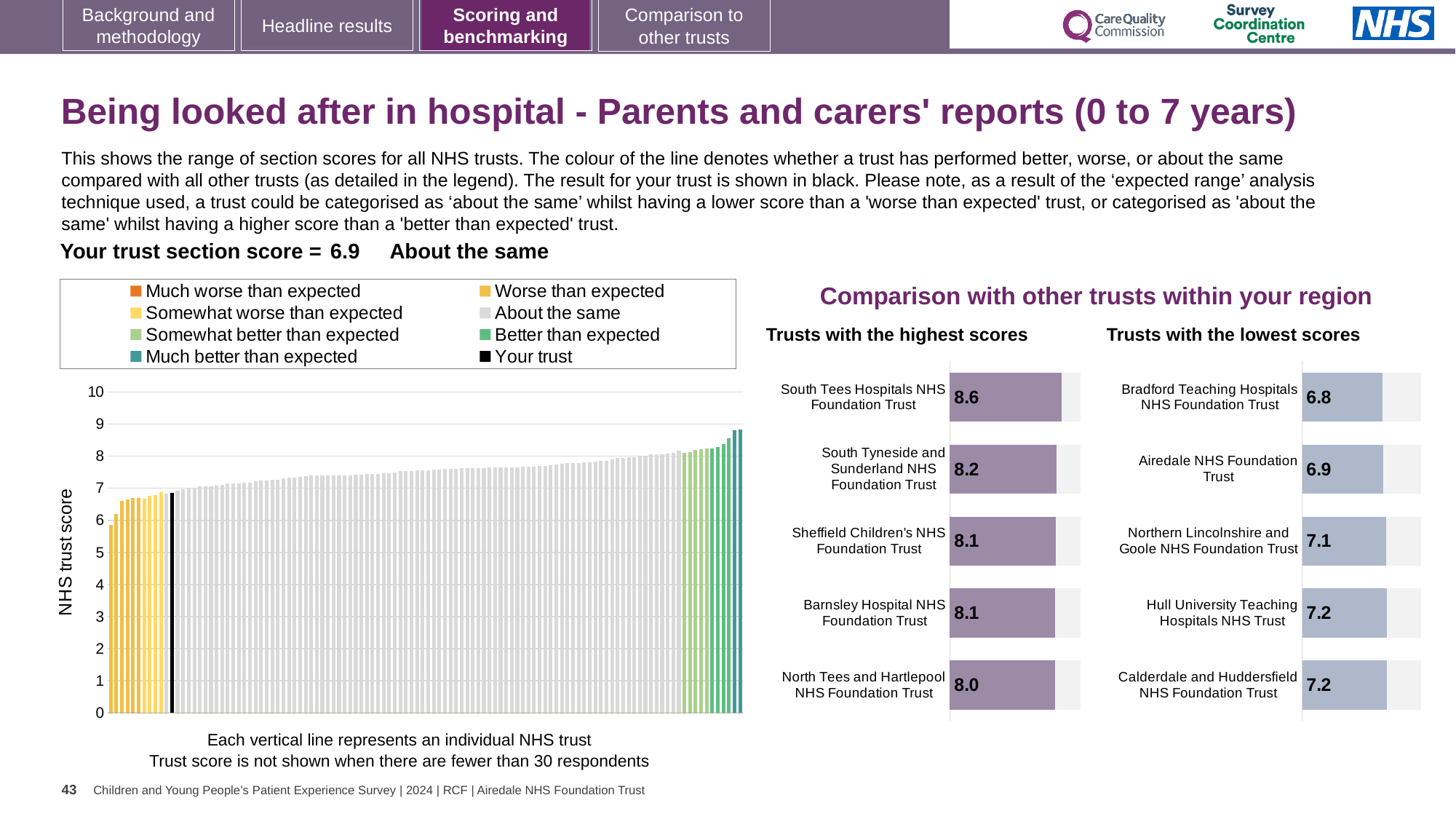
In the 'Trusts with the lowest scores' chart, which trust has the lowest score? Bradford Teaching Hospitals NHS Foundation Trust In the 'Trusts with the highest scores' chart, which trust has the lowest score shown? North Tees and Hartlepool NHS Foundation Trust What kind of chart is the large chart on the left showing NHS trust scores? Bar chart In the 'Trusts with the lowest scores' chart, what is the difference between the scores of Hull University Teaching Hospitals NHS Trust and Bradford Teaching Hospitals NHS Foundation Trust? 0.4 In the 'Trusts with the highest scores' chart, what is the difference between the scores of South Tees Hospitals NHS Foundation Trust and North Tees and Hartlepool NHS Foundation Trust? 0.6 In the 'Trusts with the lowest scores' chart, what is the score for Bradford Teaching Hospitals NHS Foundation Trust? 6.8 In the large chart on the left, do the trust scores rise or fall from left to right? Rise How many trusts are listed in the 'Trusts with the highest scores' chart? 5 In the 'Trusts with the highest scores' chart, what is the score for South Tees Hospitals NHS Foundation Trust? 8.6 In the large chart on the left, is the value of the tallest bar greater or less than 8? greater In the 'Trusts with the lowest scores' chart, which has the higher score: Airedale NHS Foundation Trust or Northern Lincolnshire and Goole NHS Foundation Trust? Northern Lincolnshire and Goole NHS Foundation Trust How many entries does the legend above the large chart on the left list? 8